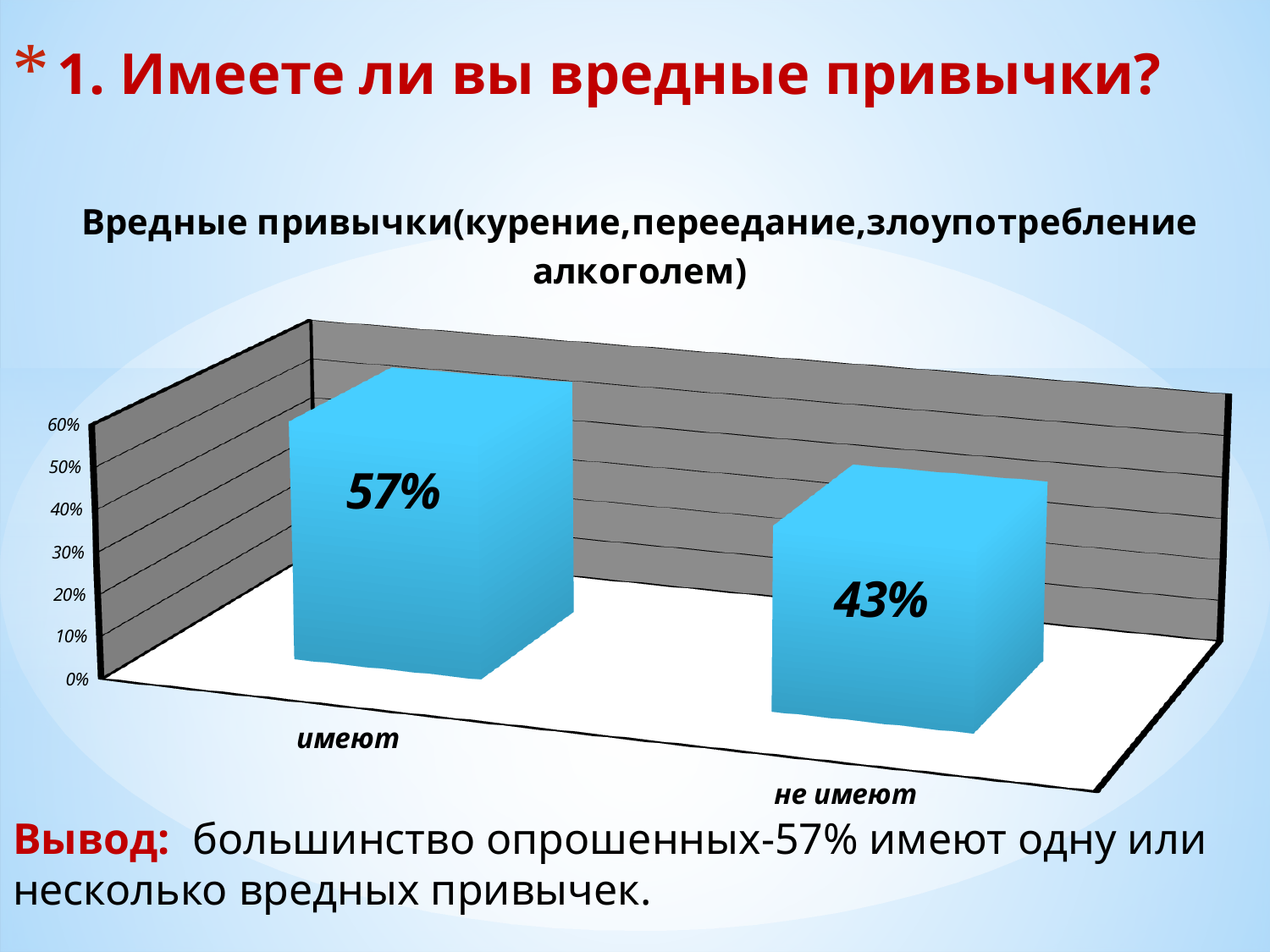
What is the value for "не имеют"? 43% Is the value for "не имеют" greater or less than 50%? less Which category has the lowest value? не имеют How many categories are shown in the chart? 2 What is the difference between the values for "имеют" and "не имеют"? 14% What kind of chart is shown on the slide? bar chart Which category has the highest value? имеют Is the value for "имеют" greater or less than 50%? greater Which is larger, the value for "имеют" or the value for "не имеют"? имеют What is the title of the chart? Вредные привычки(курение,переедание,злоупотребление алкоголем) What is the value for "имеют"? 57% What is the total of the two values shown in the chart? 100%